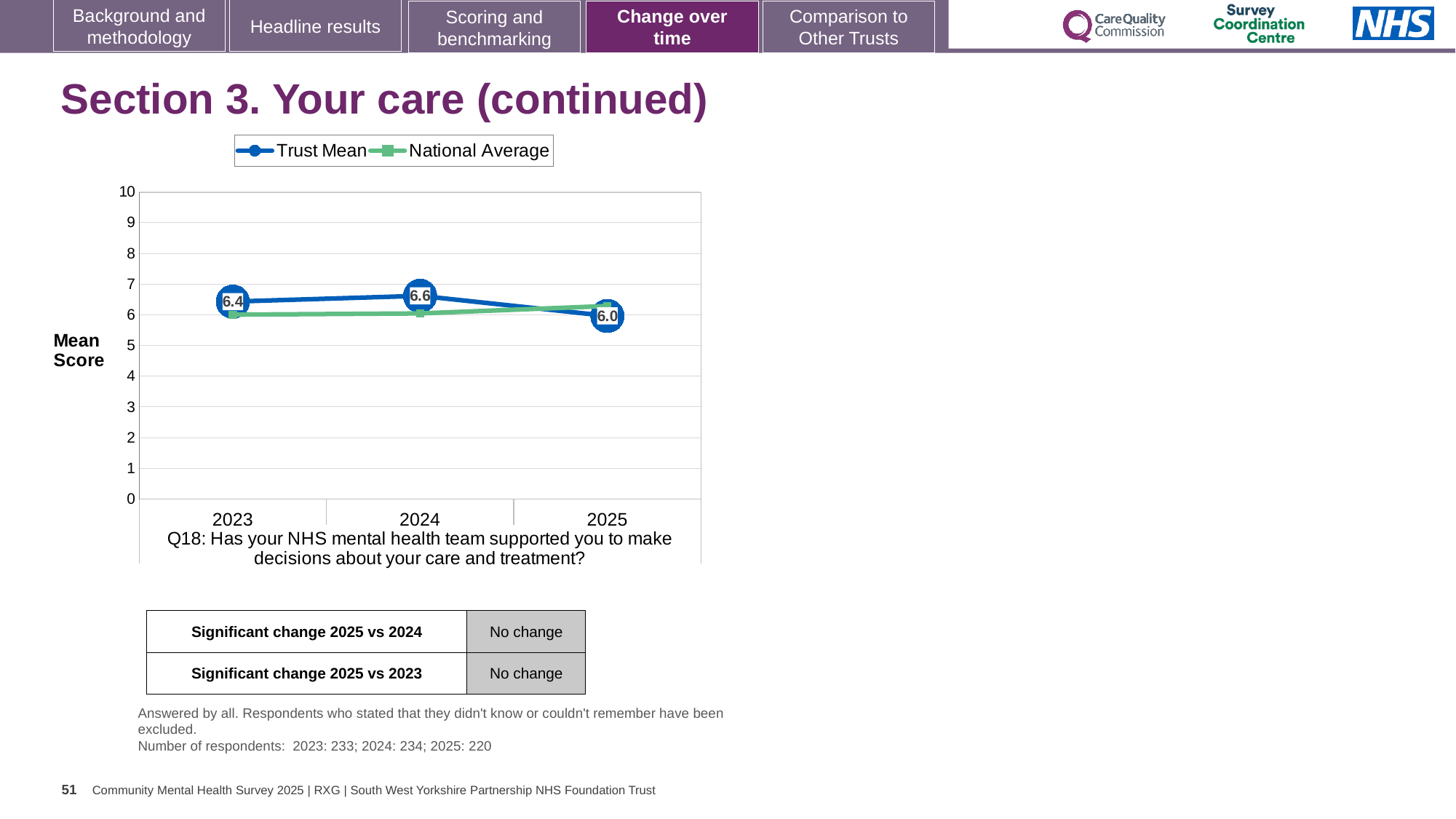
How many years are shown on the x axis of the chart? 3 Does the Trust Mean score rise or fall from 2024 to 2025? fall In which year was the Trust Mean score highest? 2024 How many series does the chart legend list? 2 What is the Trust Mean score for 2024? 6.6 Which year has the larger Trust Mean score, 2023 or 2024? 2024 Is the National Average value for 2023 greater or less than 7? less What is the Trust Mean score for 2025? 6.0 What is the difference between the Trust Mean scores for 2024 and 2025? 0.6 In which year was the Trust Mean score lowest? 2025 What kind of chart is shown on the slide? line chart What is the Trust Mean score for 2023? 6.4